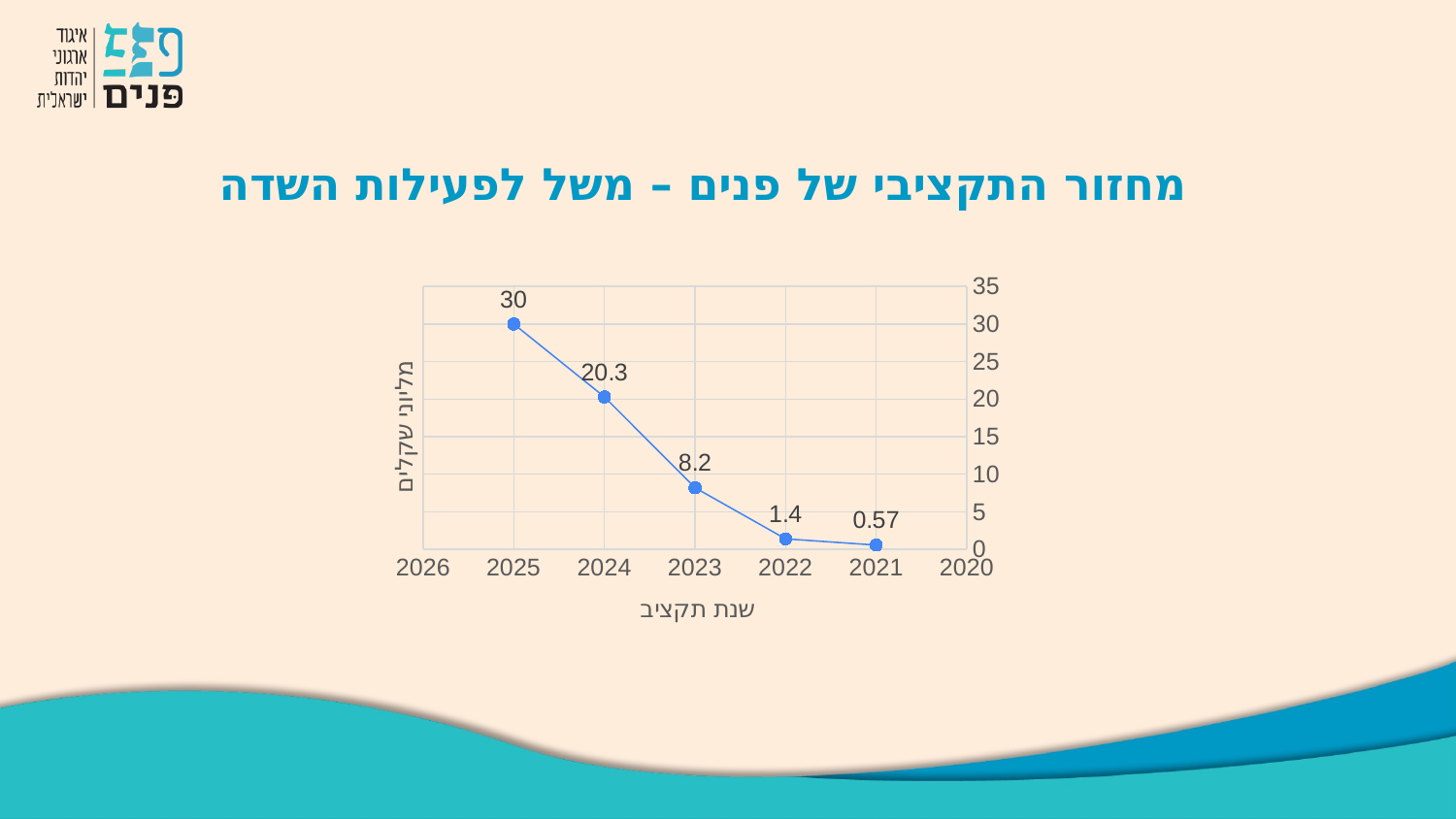
What is the difference between the values for 2025 and 2024? 9.7 Which is larger, the value for 2023 or the value for 2022? 2023 How many data points are plotted on the chart? 5 Which year has the highest value? 2025 What is the value for 2025? 30 What is the value for 2021? 0.57 What is the value for 2022? 1.4 What is the value for 2023? 8.2 Do the values rise or fall as the year increases from 2021 to 2025? rise Which year has the lowest value? 2021 What is the value for 2024? 20.3 What kind of chart is shown on the slide? line chart